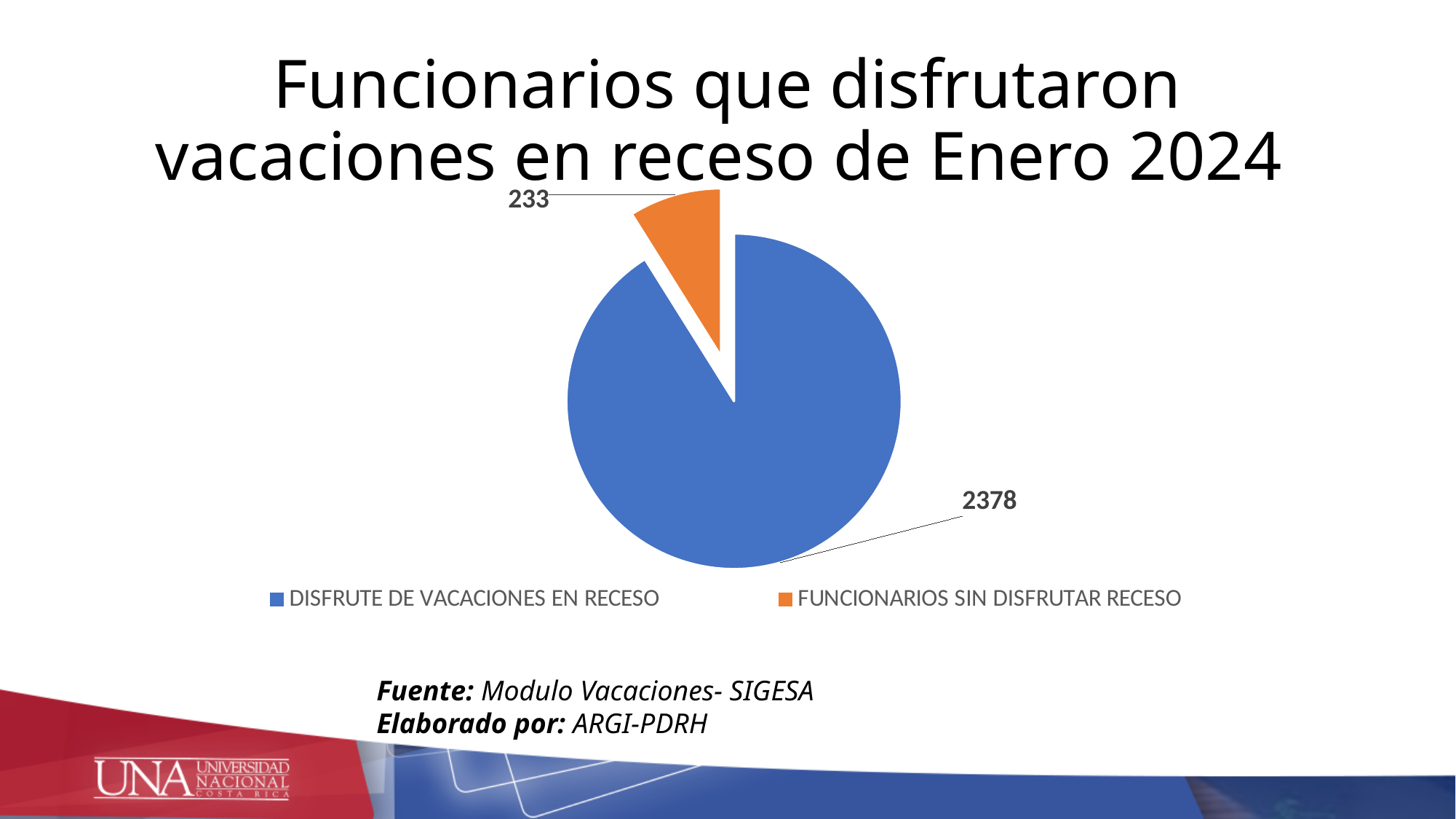
Which is larger: the value for DISFRUTE DE VACACIONES EN RECESO or the value for FUNCIONARIOS SIN DISFRUTAR RECESO? DISFRUTE DE VACACIONES EN RECESO What is the total of the two values shown in the pie chart? 2611 What is the difference between the value for DISFRUTE DE VACACIONES EN RECESO and the value for FUNCIONARIOS SIN DISFRUTAR RECESO? 2145 Which colour represents FUNCIONARIOS SIN DISFRUTAR RECESO in the pie chart? orange Which category has the smallest slice of the pie? FUNCIONARIOS SIN DISFRUTAR RECESO How many categories does the pie chart have? 2 What is the value for FUNCIONARIOS SIN DISFRUTAR RECESO? 233 What is the title of the chart on the slide? Funcionarios que disfrutaron vacaciones en receso de Enero 2024 What type of chart is shown on the slide? pie chart Which category has the largest slice of the pie? DISFRUTE DE VACACIONES EN RECESO What is the value for DISFRUTE DE VACACIONES EN RECESO? 2378